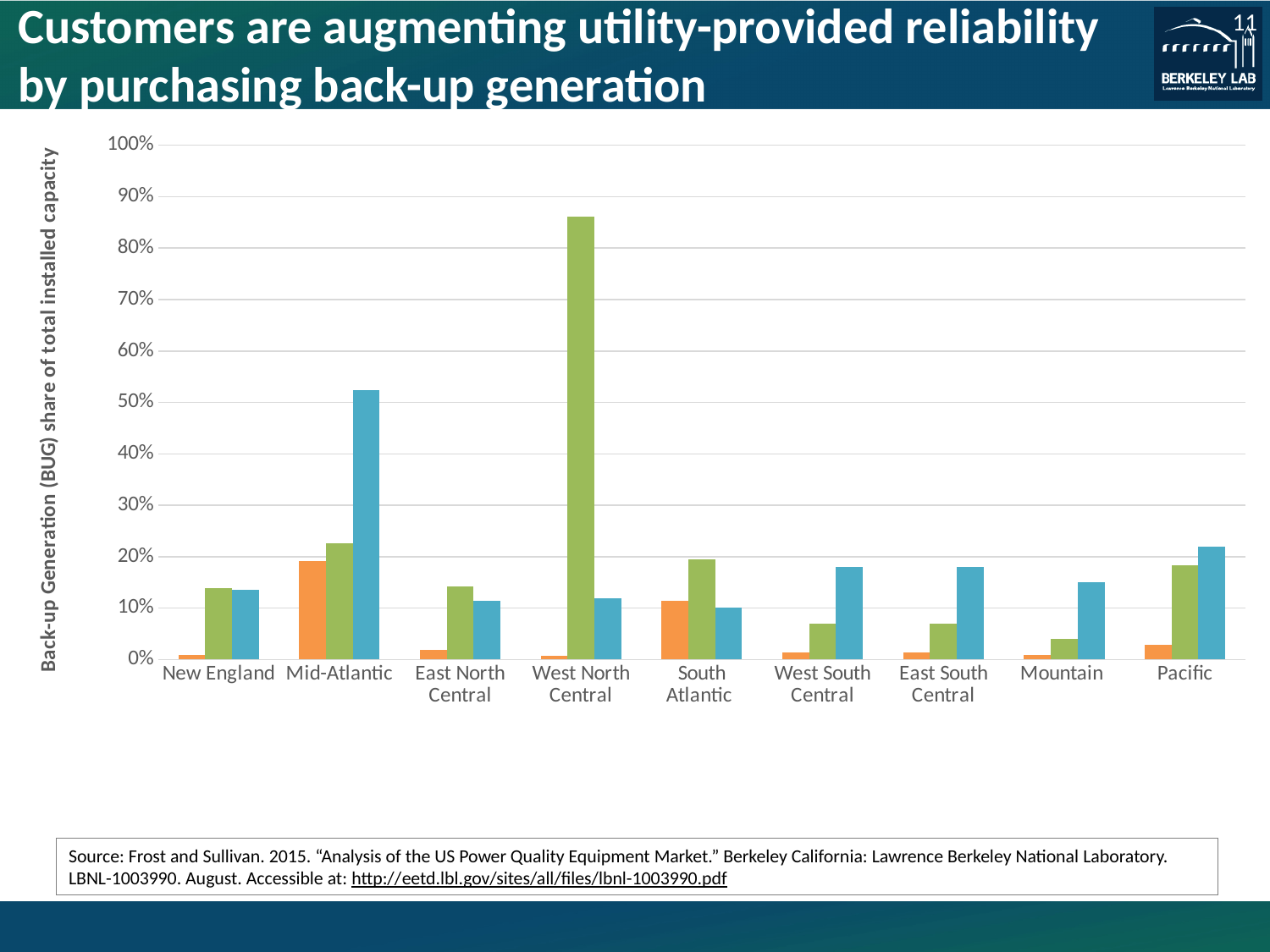
Is the blue bar for Mountain greater or less than 20%? less Is the orange bar for New England greater or less than 10%? less Which region has the tallest bar in the chart? West North Central What kind of chart is shown on the slide? bar chart Is the green bar for West North Central greater or less than 80%? greater Which region has the tallest orange bar? Mid-Atlantic Which is larger, the orange bar for South Atlantic or the orange bar for West South Central? South Atlantic How many regions are shown along the x axis of the chart? 9 What is the label on the vertical axis of the chart? Back-up Generation (BUG) share of total installed capacity Which is larger, the blue bar for Mid-Atlantic or the blue bar for Pacific? Mid-Atlantic